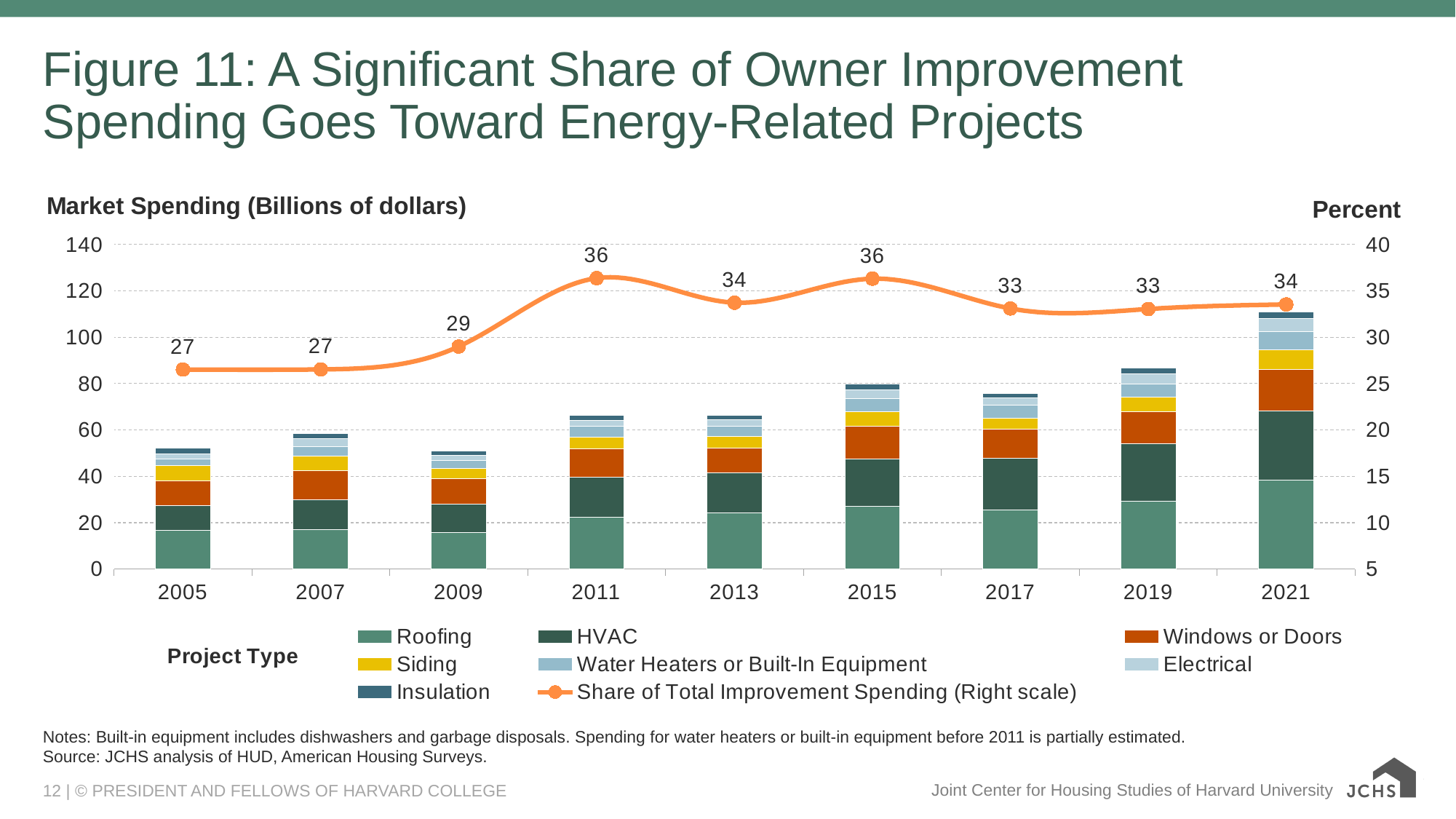
What kind of chart is shown on the slide? Combination stacked bar and line chart Is the total market spending bar for 2005 greater or less than 60? less How many years are shown on the x axis? 9 Is the Share of Total Improvement Spending higher in 2013 or in 2017? 2013 Is the total market spending bar for 2021 greater or less than 100? greater Which year has the tallest stacked bar for market spending? 2021 What is the Share of Total Improvement Spending in 2021? 34 What is the lowest value shown on the Share of Total Improvement Spending line? 27 How many entries does the legend list? 8 By how many percentage points did the Share of Total Improvement Spending change from 2005 to 2011? 9 What is the Share of Total Improvement Spending in 2005? 27 What is the Share of Total Improvement Spending in 2011? 36